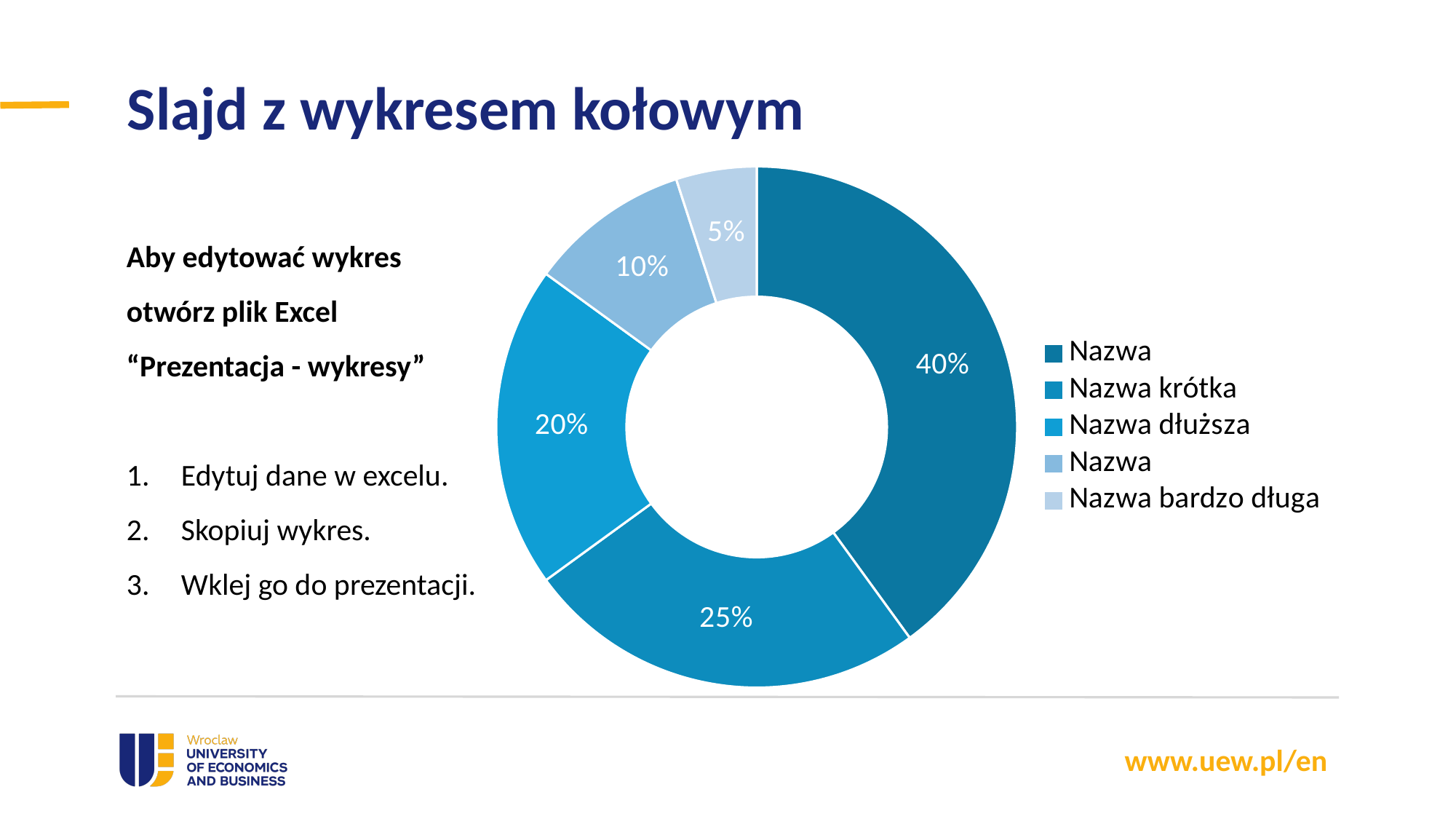
What percentage is shown for the slice labelled "Nazwa krótka"? 25% What percentage is shown for the slice labelled "Nazwa bardzo długa"? 5% What percentage is shown for the slice labelled "Nazwa dłuższa"? 20% What is the combined share of the "Nazwa krótka" and "Nazwa bardzo długa" slices? 30% What is the title of the slide containing the chart? Slajd z wykresem kołowym What kind of chart is shown on the slide? doughnut (pie) chart What is the largest percentage shown on the chart? 40% What is the difference in percentage points between the "Nazwa krótka" slice and the "Nazwa dłuższa" slice? 5 Which legend entry corresponds to the smallest slice of the chart? Nazwa bardzo długa Which slice is larger, "Nazwa krótka" or "Nazwa dłuższa"? Nazwa krótka How many slices does the chart have? 5 How many entries does the legend list? 5